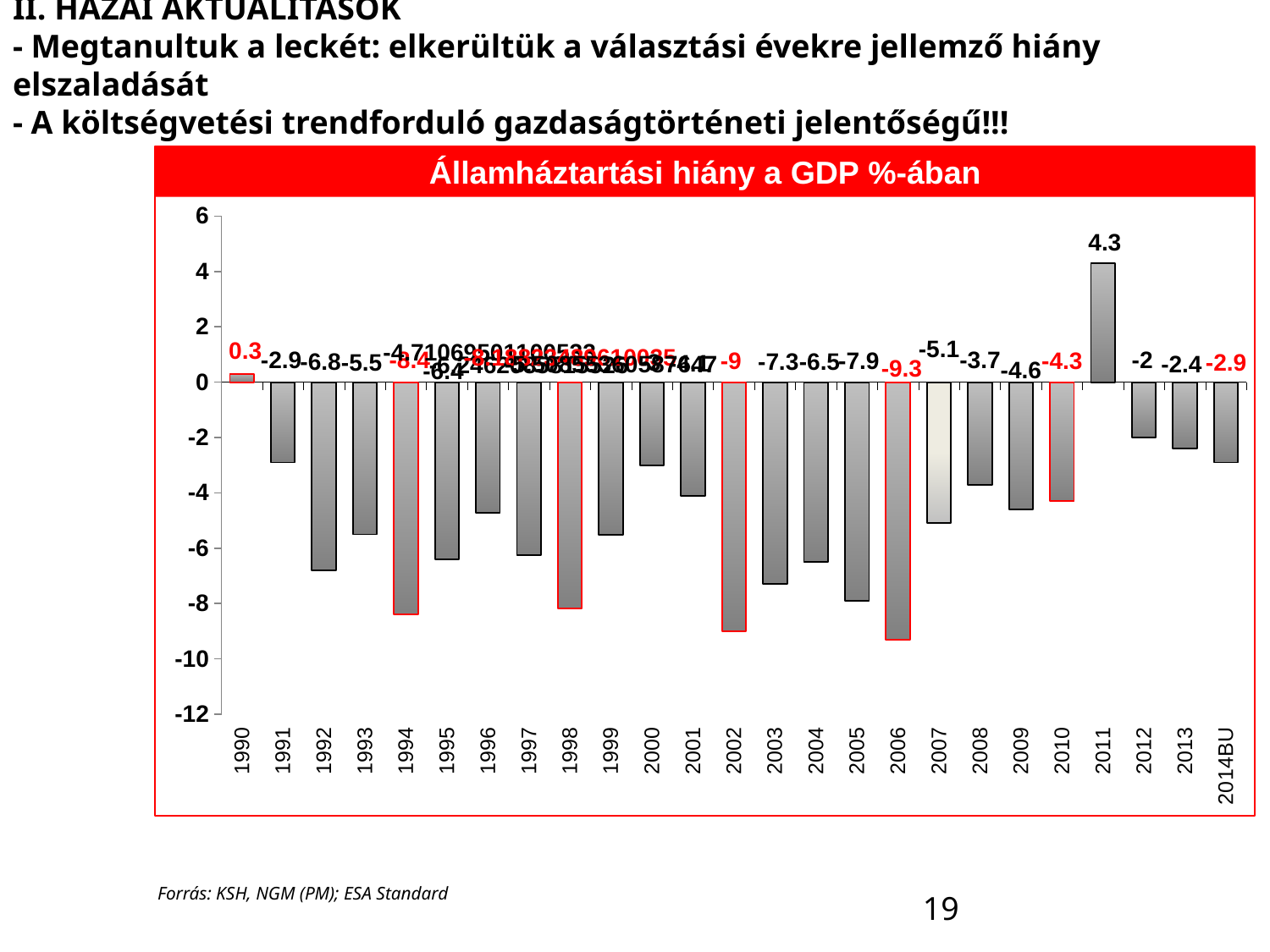
How many years are shown on the x axis? 25 What is the title of the chart? Államháztartási hiány a GDP %-ában What is the value for 2014BU? -2.9 Which year has the lowest value? 2006 What is the value for 1990? 0.3 What is the difference between the values for 2011 and 2010? 8.6 Which is larger, the value for 1992 or the value for 1993? 1993 What is the value for 2011 in the chart 'Államháztartási hiány a GDP %-ában'? 4.3 What is the value for 2006? -9.3 Which year has the highest value? 2011 Is the value for 1999 greater or less than -4? less What kind of chart is shown on the slide? bar chart